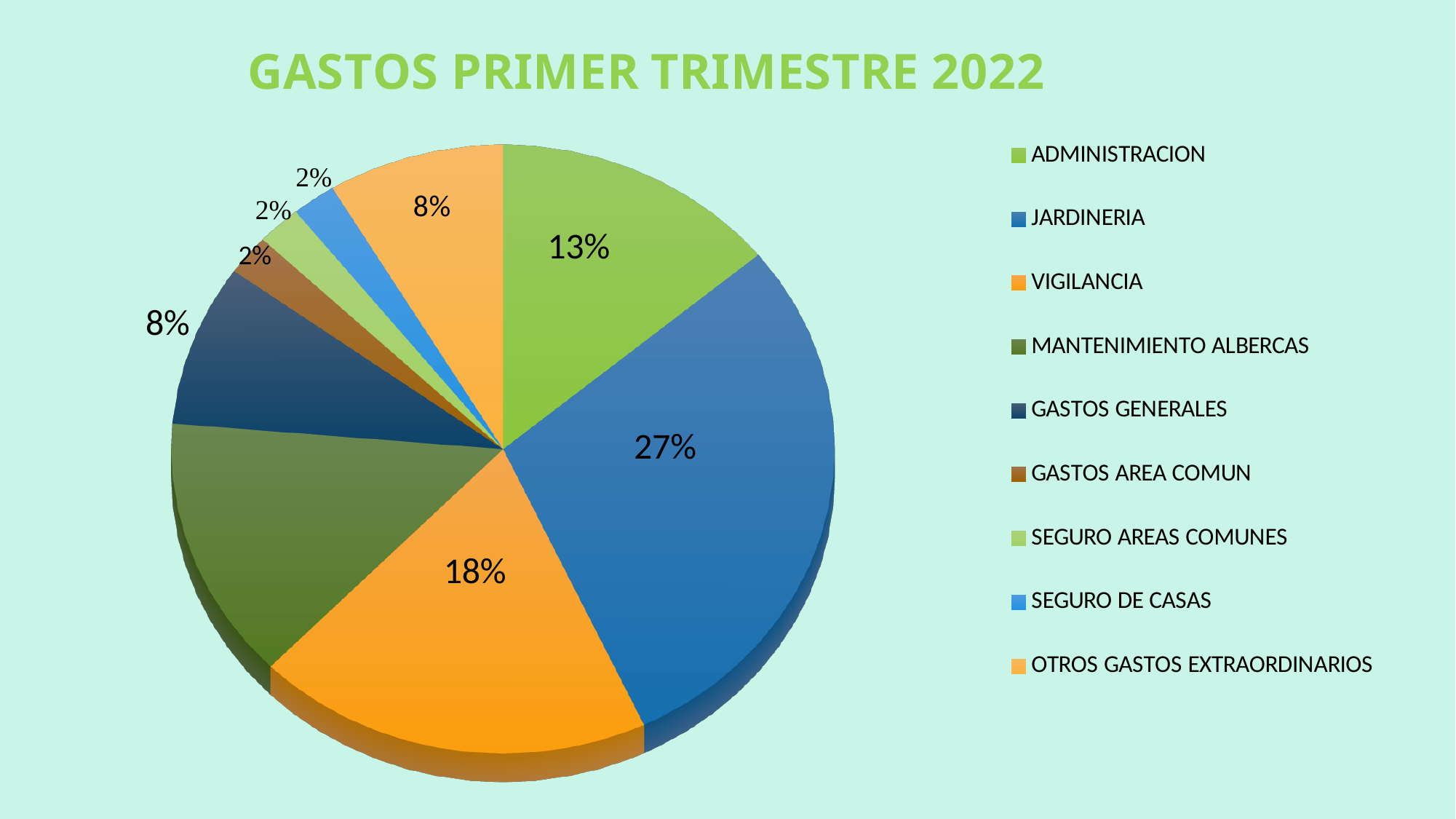
Which category has the largest slice of the pie? JARDINERIA What is the value shown for VIGILANCIA? 18% What percentage of the pie does JARDINERIA represent? 27% Which is larger, VIGILANCIA or ADMINISTRACION? VIGILANCIA What is the difference in percentage points between JARDINERIA and VIGILANCIA? 9 What is the title of the chart? GASTOS PRIMER TRIMESTRE 2022 What percentage is labelled for ADMINISTRACION? 13% What is the difference in percentage points between ADMINISTRACION and GASTOS GENERALES? 5 What kind of chart is shown on the slide? Pie chart What is the value shown for GASTOS GENERALES? 8% How many categories does the legend list? 9 What percentage does OTROS GASTOS EXTRAORDINARIOS account for? 8%